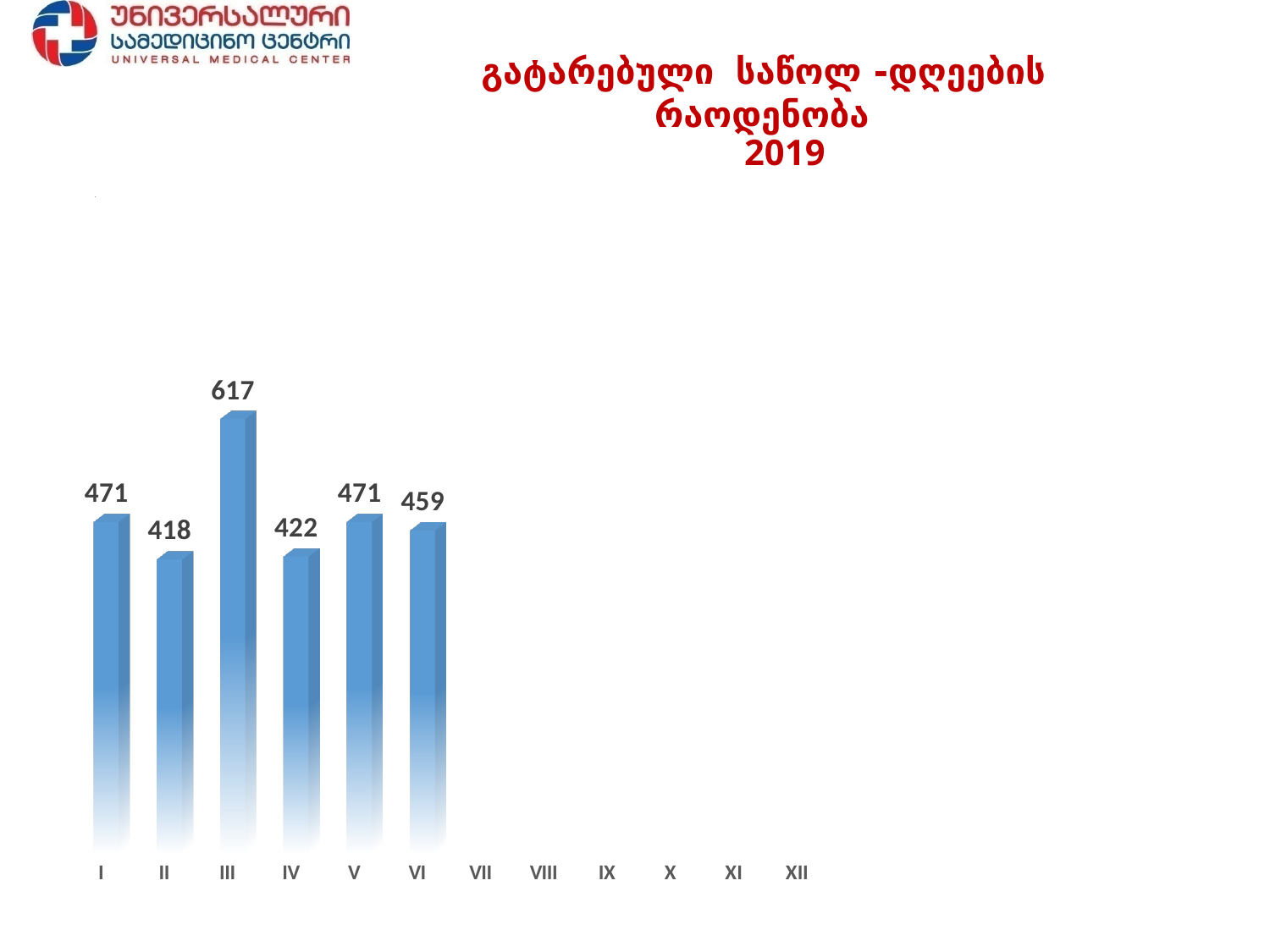
What is the difference between the values for month V and month VI? 12 What is the value for month VI? 459 How many months have bars with data labels shown? 6 What is the value for month III? 617 What is the value for month II? 418 How many category labels are shown on the x axis? 12 Which month has the lowest value among those with data labels? II What is the difference between the values for month III and month II? 199 Which is larger, the value for month IV or the value for month VI? VI Which month has the highest value? III What kind of chart is shown on the slide? Bar chart What is the value for month IV? 422